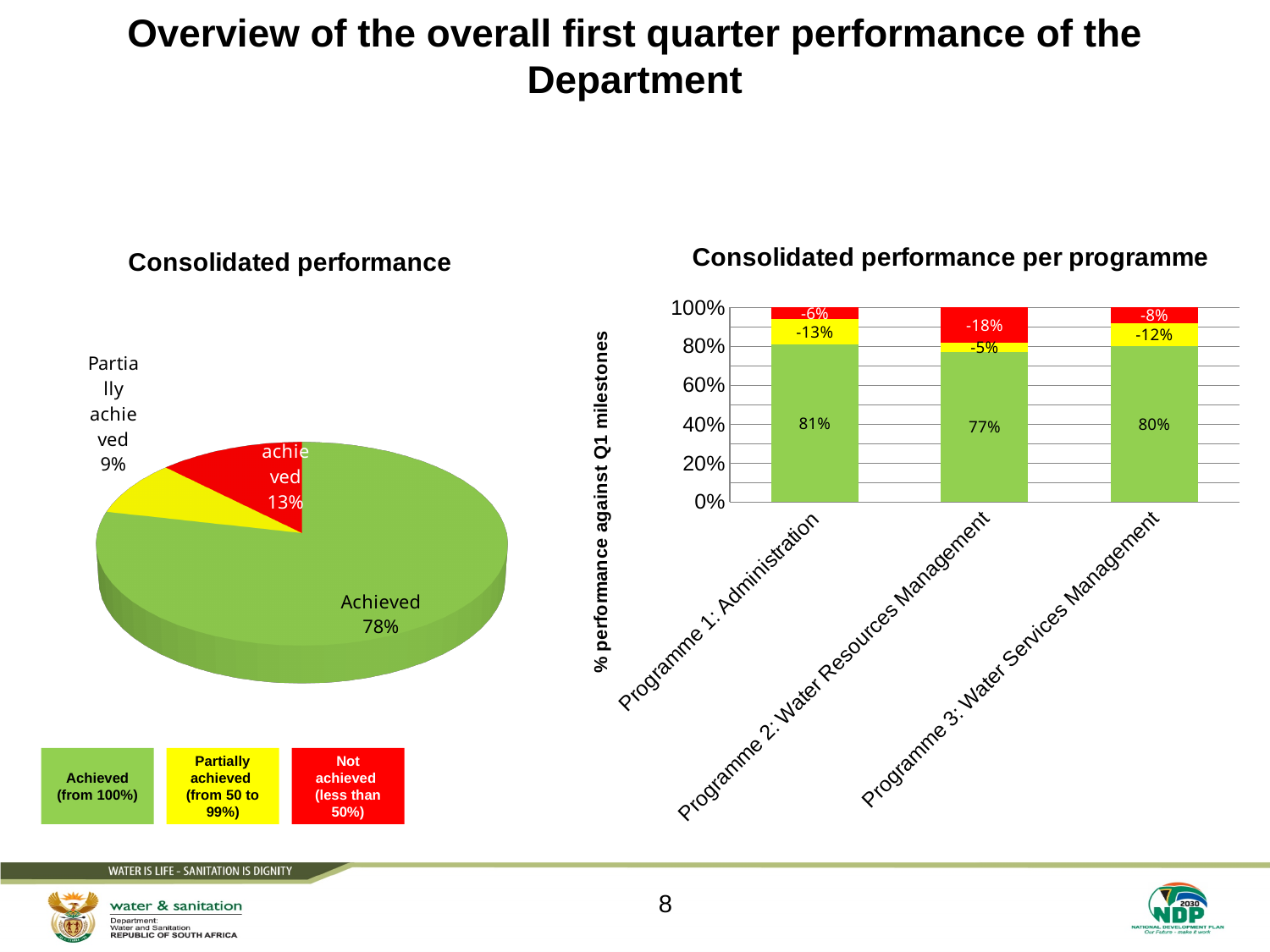
In the Consolidated performance per programme chart, what is the difference between the green segment values of Programme 1: Administration and Programme 2: Water Resources Management? 4% In the Consolidated performance per programme chart, what value is labelled on the green segment for Programme 2: Water Resources Management? 77% In the Consolidated performance pie chart, what percentage is labelled for the Achieved slice? 78% In the Consolidated performance per programme chart, which programme has the lowest green segment value? Programme 2: Water Resources Management How many programmes are shown on the x axis of the Consolidated performance per programme chart? 3 In the Consolidated performance per programme chart, what value is labelled on the red segment for Programme 2: Water Resources Management? -18% In the Consolidated performance pie chart, what percentage is labelled for the Partially achieved slice? 9% What kind of chart is the Consolidated performance chart on the left? Pie chart How many slices does the Consolidated performance pie chart have? 3 In the Consolidated performance per programme chart, what value is labelled on the green segment for Programme 1: Administration? 81% What is the y-axis title of the Consolidated performance per programme chart? % performance against Q1 milestones In the Consolidated performance per programme chart, what value is labelled on the green segment for Programme 3: Water Services Management? 80%